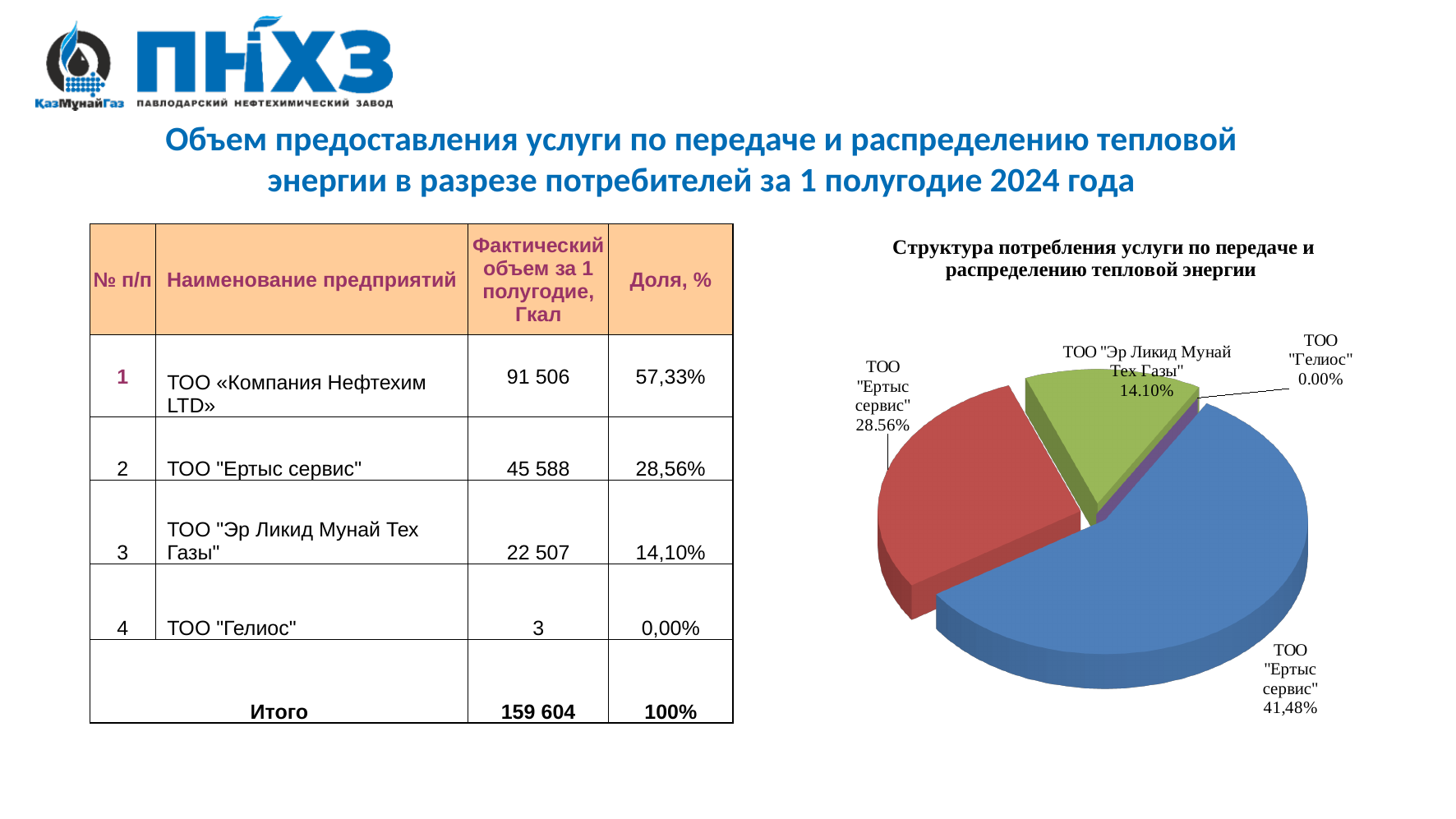
How many slices does the pie chart have? 4 What colour is the slice for ТОО "Эр Ликид Мунай Тех Газы" in the pie chart? green Which company has the smallest slice in the pie chart? ТОО "Гелиос" What percentage is printed on the blue slice of the pie chart? 41,48% What is the title of the pie chart? Структура потребления услуги по передаче и распределению тепловой энергии What is the difference between the share printed on the red slice (28.56%) and the share for ТОО "Эр Ликид Мунай Тех Газы" (14.10%)? 14.46% What share of the pie is labelled for ТОО "Эр Ликид Мунай Тех Газы"? 14.10% Which slice is larger: ТОО "Эр Ликид Мунай Тех Газы" or ТОО "Гелиос"? ТОО "Эр Ликид Мунай Тех Газы" What share of the pie is labelled for ТОО "Гелиос"? 0.00% What percentage is printed on the red slice of the pie chart? 28.56% What kind of chart is shown on the slide? pie chart Which colour is the largest slice of the pie chart? blue